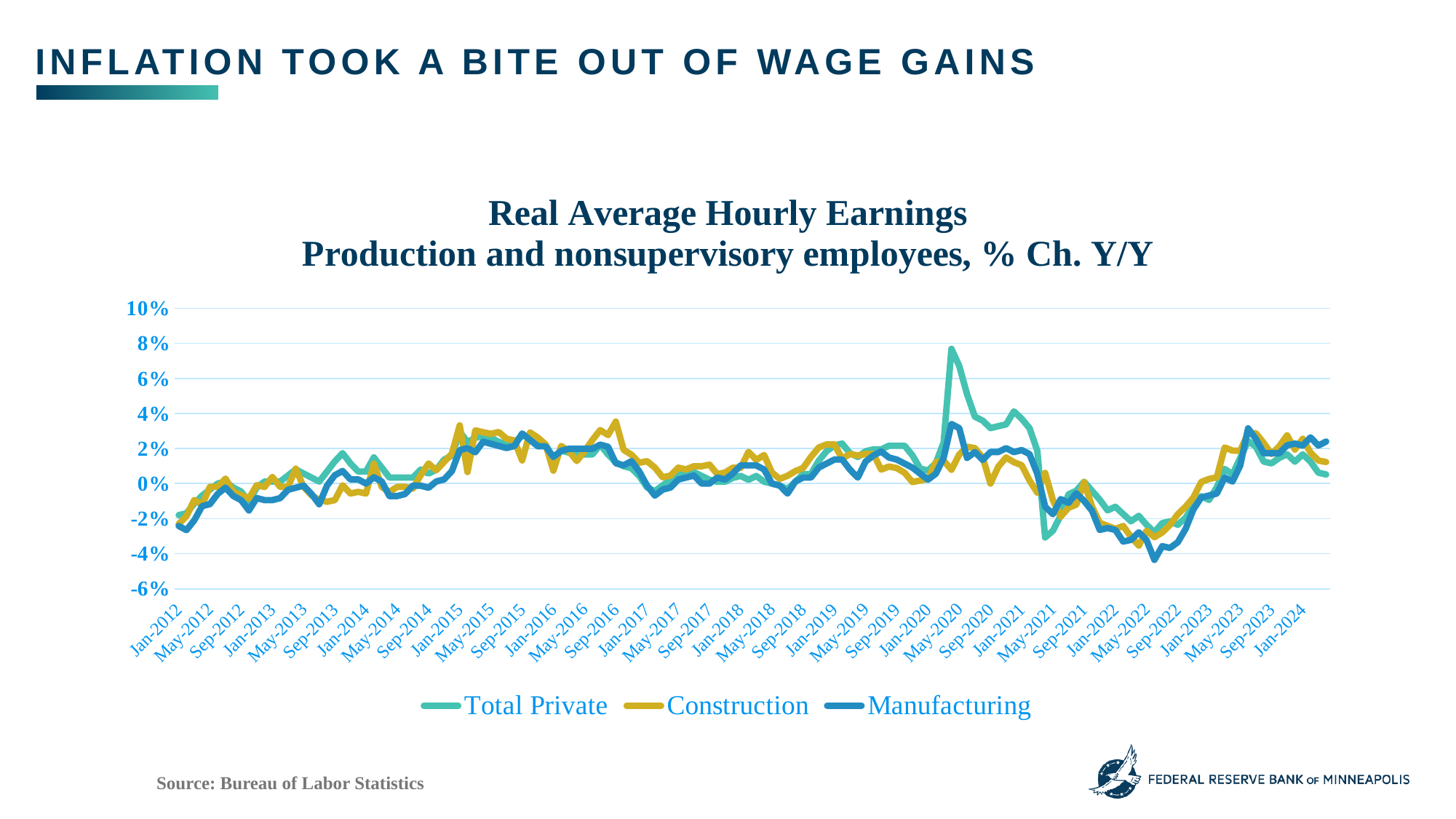
What is the source cited for the chart? Bureau of Labor Statistics Is the peak value of Total Private around May-2020 greater or less than 6%? greater Is the value for Total Private at Jan-2024 greater or less than 2%? less Which series reaches the highest value on the chart, peaking around May-2020? Total Private Does the Total Private series rise or fall between May-2020 and May-2022? Fall Which series reaches the lowest value on the chart, around mid-2022? Manufacturing At Jan-2024, which is larger: Manufacturing or Total Private? Manufacturing Is the value for Construction around Sep-2016 greater or less than 2%? greater How many series does the legend list? 3 Which series are listed in the legend? Total Private, Construction, Manufacturing What kind of chart is shown on the slide? Line chart